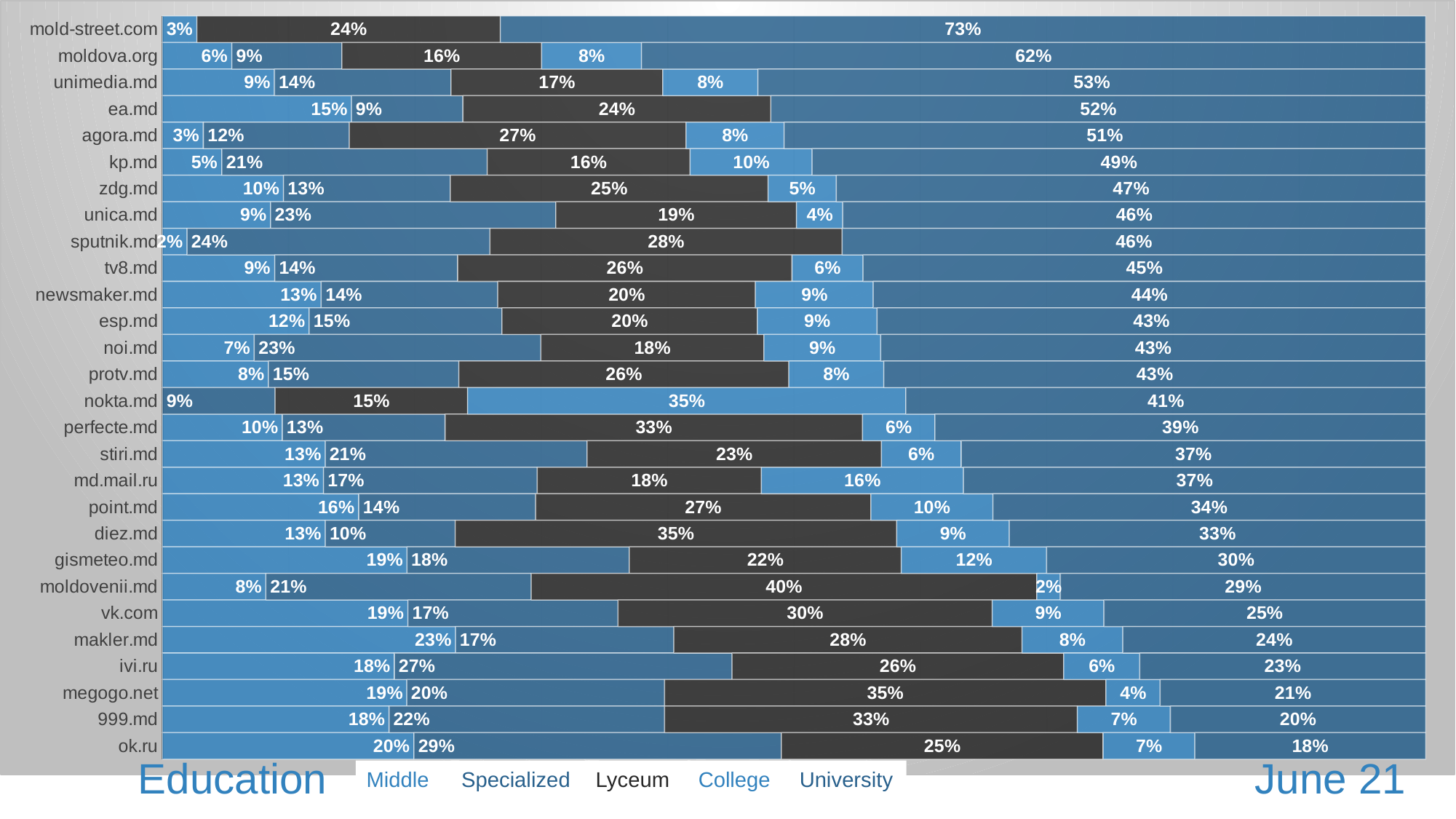
What is the title of the chart? Education What is the University share for ok.ru? 18% What is the difference in University share between mold-street.com and ok.ru? 55 percentage points What is the Lyceum share for moldovenii.md? 40% Which website has the lowest University share? ok.ru Which website has the highest University share? mold-street.com What kind of chart is shown on the slide? Stacked bar chart How many websites (categories) are plotted in the chart? 28 How many series does the legend list? 5 Which has the larger Lyceum share, diez.md or gismeteo.md? diez.md What is the University share for mold-street.com? 73% What is the College share for md.mail.ru? 16%